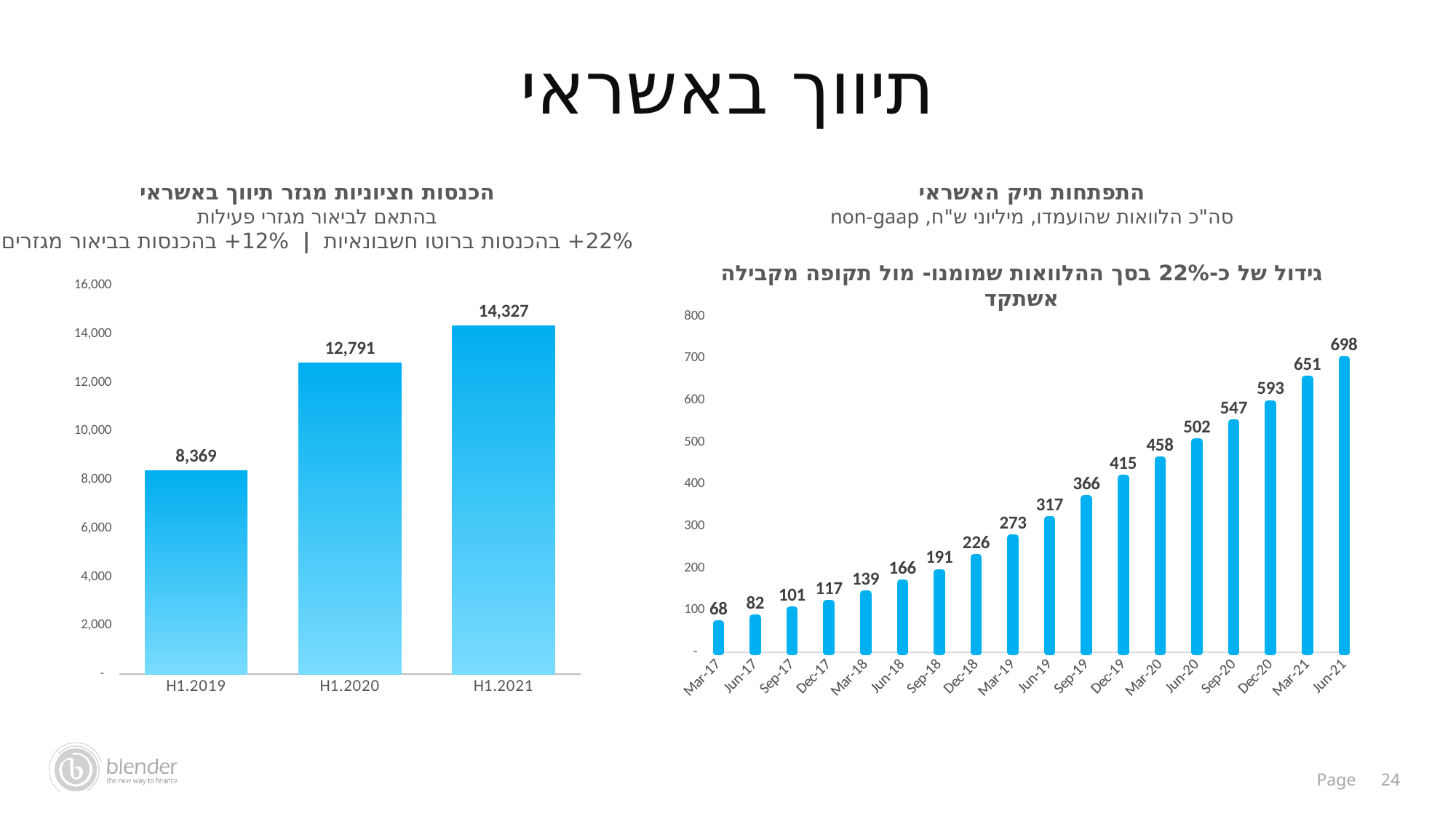
On the right chart, what is the value for Dec-19? 415 On the right chart, what is the difference between the Jun-21 and Jun-20 values? 196 On the left chart, what is the value for H1.2020? 12,791 On the right chart, what is the value for Jun-21? 698 What kind of chart is the right chart? Bar chart On the right chart, which period has the lowest value? Mar-17 On the right chart, do the values rise or fall from Mar-17 to Jun-21? Rise On the left chart, what is the difference between the H1.2021 and H1.2020 values? 1,536 On the left chart, which period has the highest value? H1.2021 On the right chart, how many periods are plotted along the x axis? 18 On the left chart, how many bars are plotted? 3 On the left chart, what is the value for H1.2019? 8,369